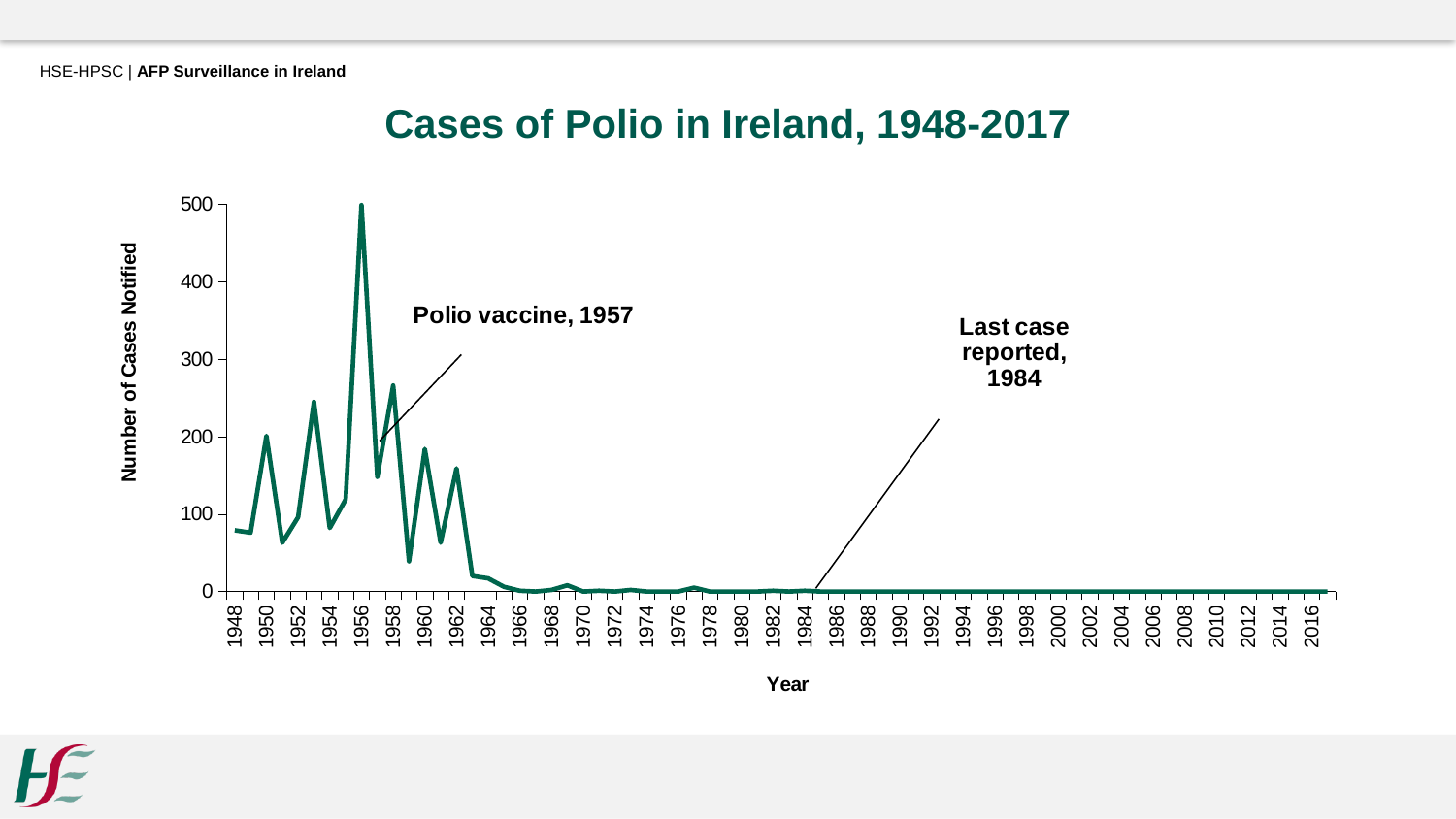
In which year was the number of polio cases notified highest? 1956 Is the number of cases notified in 1956 greater or less than 400? greater Which year had more cases notified, 1956 or 1958? 1956 According to the annotation on the chart, in what year was the polio vaccine introduced? 1957 What kind of chart is shown on the slide? line chart Which year had more cases notified, 1953 or 1950? 1953 Is the number of cases notified in 1953 greater or less than 200? greater Is the number of cases notified in 1959 greater or less than 100? less Do the number of cases notified rise or fall between 1962 and 1966? fall What is the title of the chart? Cases of Polio in Ireland, 1948-2017